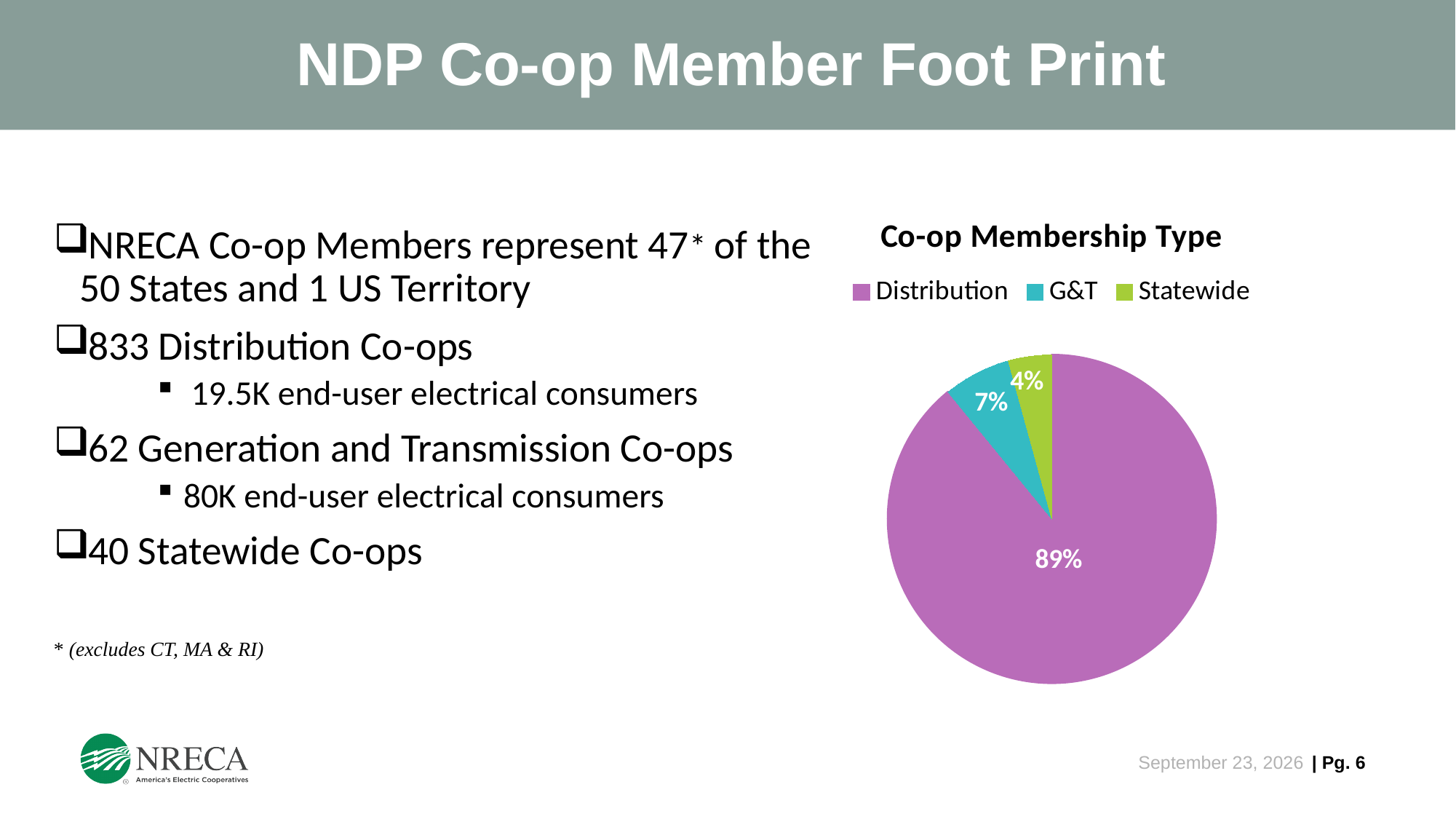
Which is larger, the G&T slice or the Statewide slice? G&T What is the difference in percentage points between the Distribution and G&T slices? 82 What colour is the Distribution slice? purple Which membership type has the largest slice? Distribution What share of the pie is Statewide? 4% What share of the pie is Distribution? 89% How many slices does the pie chart have? 3 What share of the pie is G&T? 7% Which membership type has the smallest slice? Statewide What is the title of the chart? Co-op Membership Type What kind of chart is shown on the slide? pie chart How many entries does the legend list? 3